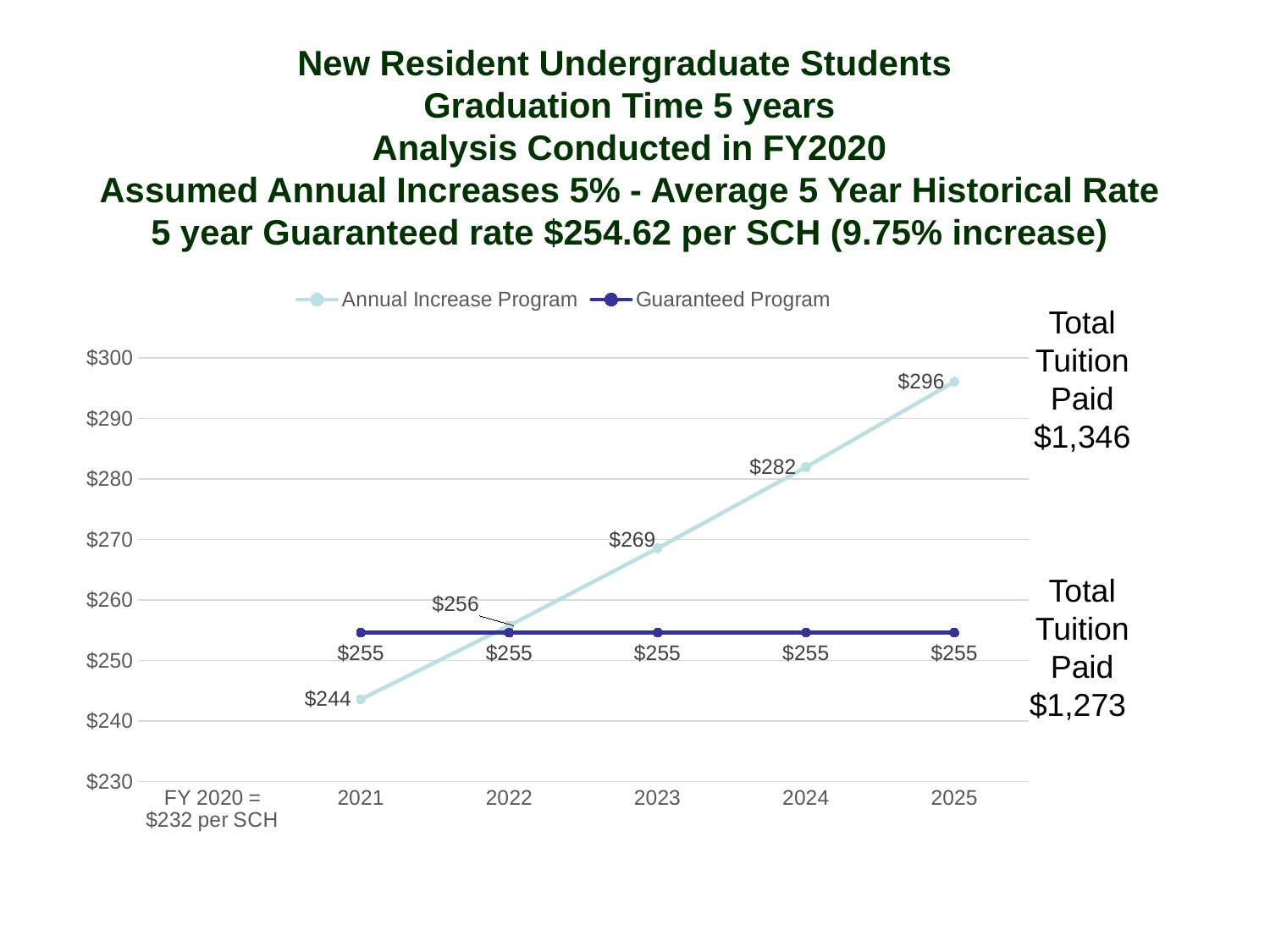
What type of chart is shown on the slide? Line chart What is the value for the Guaranteed Program in 2024? $255 What is the value for the Annual Increase Program in 2023? $269 What is the Total Tuition Paid shown for the Guaranteed Program? $1,273 What is the difference between the Annual Increase Program value in 2025 and in 2021? $52 In which year is the Annual Increase Program value highest? 2025 In which year is the Annual Increase Program value lowest? 2021 How many data points are plotted for the Guaranteed Program series? 5 Does the Annual Increase Program value rise or fall from 2021 to 2025? Rise What is the value for the Annual Increase Program in 2025? $296 Which is larger in 2022: the Annual Increase Program value or the Guaranteed Program value? Annual Increase Program How many series does the legend list? 2